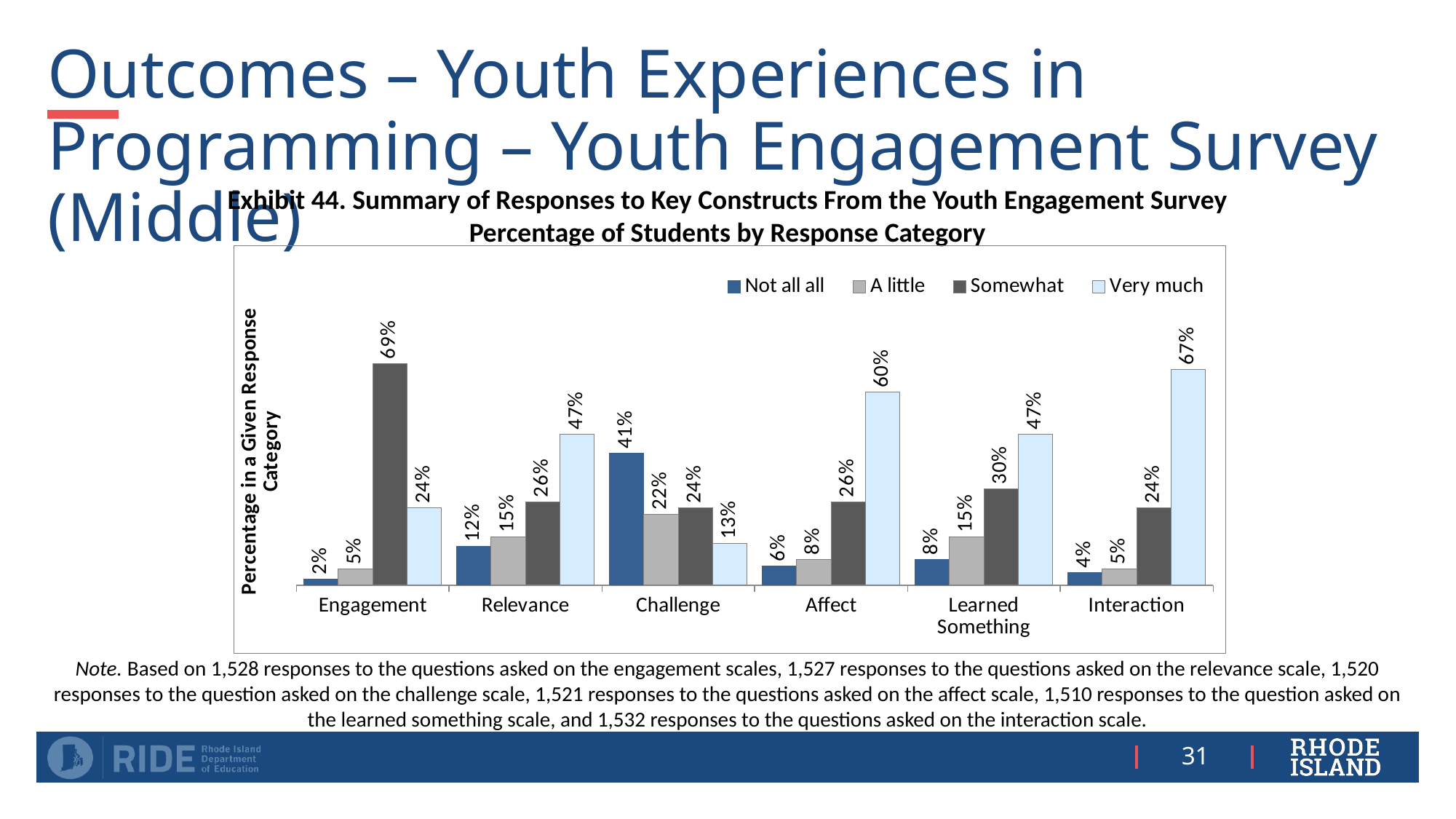
How many categories are shown on the x axis? 6 What is the difference between the "Very much" values for Affect and Relevance? 13% Which is larger for Challenge: the "A little" value or the "Somewhat" value? Somewhat What kind of chart is shown? Bar chart What is the label of the y axis? Percentage in a Given Response Category How many series does the legend list? 4 What percentage of students responded "Somewhat" for Engagement? 69% What is the "Very much" value for Interaction? 67% Which category has the lowest "Not all all" value? Engagement What is the "A little" value for Learned Something? 15% Which category has the highest "Very much" value? Interaction What is the "Not all all" value for Challenge? 41%